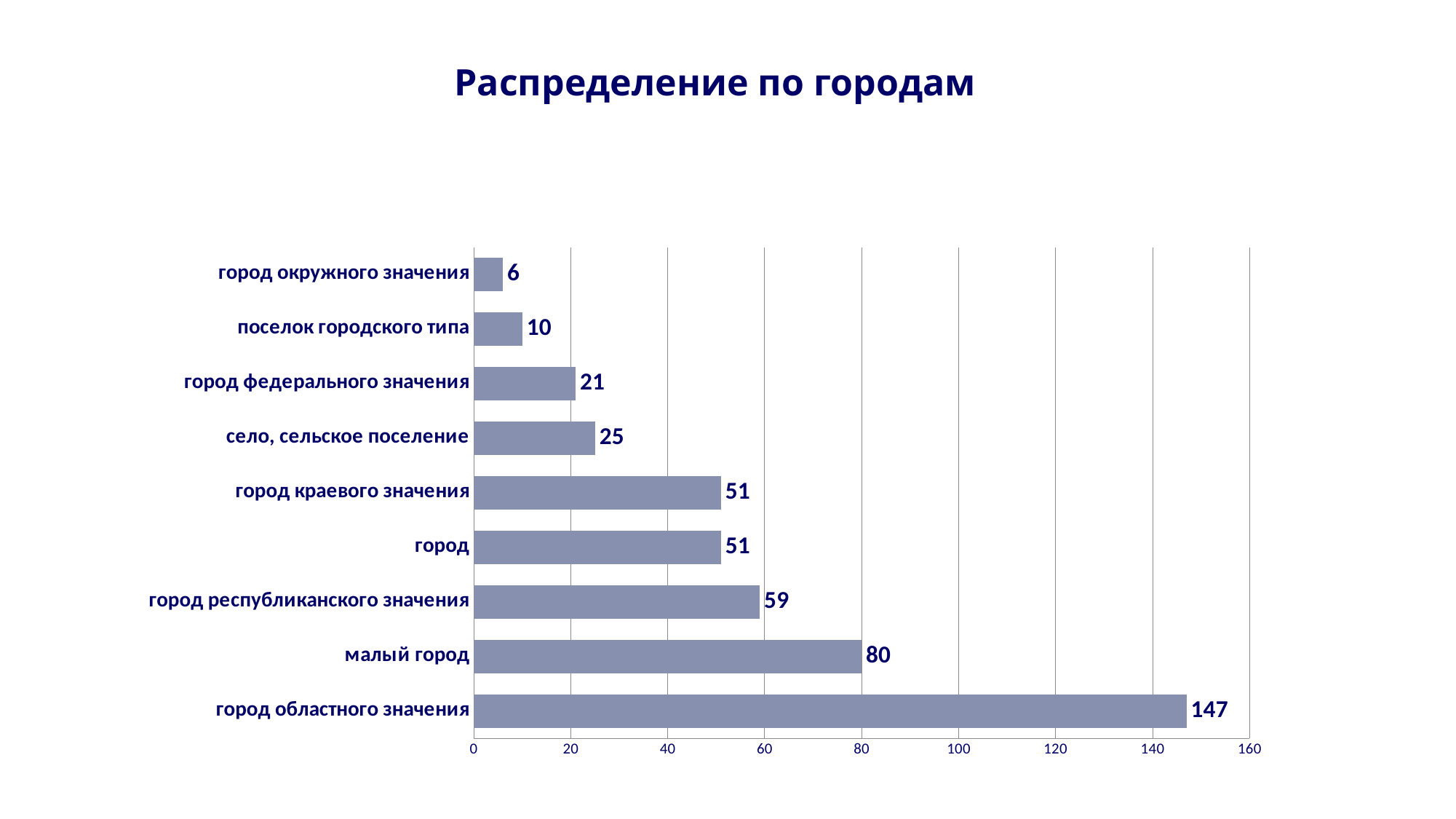
Which category has the highest value? город областного значения What is the value for "малый город"? 80 What is the difference between the values for "город областного значения" and "малый город"? 67 Which category has the lowest value? город окружного значения Which is larger, the value for "город краевого значения" or the value for "село, сельское поселение"? город краевого значения What is the difference between the values for "город республиканского значения" and "поселок городского типа"? 49 What is the value for "село, сельское поселение"? 25 Is the value for "город областного значения" greater or less than 140? greater How many categories are shown in the chart? 9 What is the title of the chart? Распределение по городам What is the value for "город федерального значения"? 21 What kind of chart is shown on the slide? bar chart